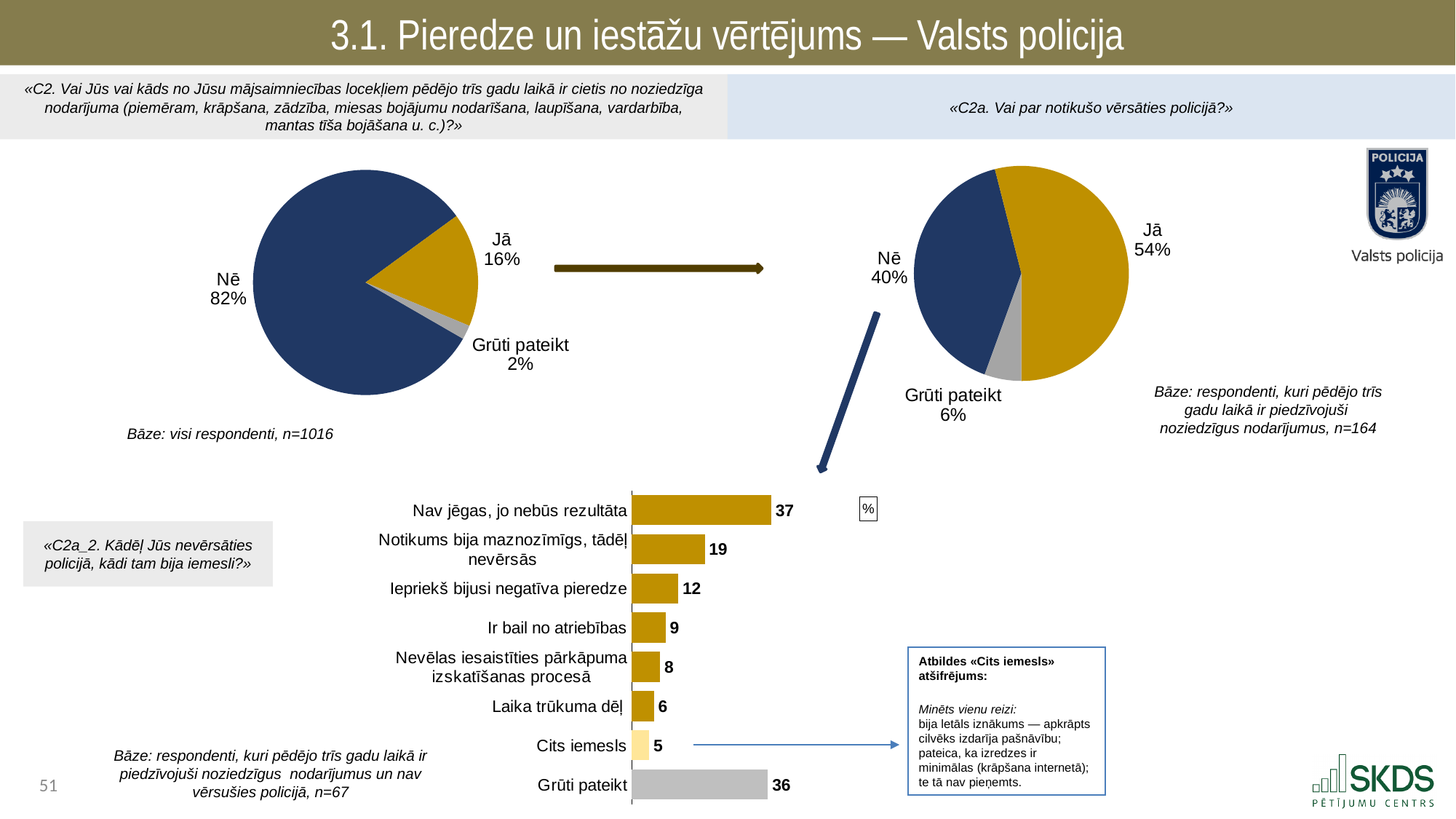
In the bottom bar chart (C2a_2), what is the difference between "Nav jēgas, jo nebūs rezultāta" and "Grūti pateikt"? 1 In the bottom bar chart (C2a_2), which is larger: "Notikums bija maznozīmīgs, tādēļ nevērsās" or "Iepriekš bijusi negatīva pieredze"? Notikums bija maznozīmīgs, tādēļ nevērsās What type of chart is used for question C2a_2 at the bottom of the slide? Bar chart In the right pie chart (C2a), which answer has the smallest share? Grūti pateikt In the bottom bar chart (C2a_2), which category has the lowest value? Cits iemesls In the left pie chart (C2), what share of respondents answered "Nē"? 82% In the bottom bar chart (C2a_2), what is the value for "Ir bail no atriebības"? 9 In the right pie chart (C2a), what is the difference between the "Jā" and "Nē" shares? 14% In the left pie chart (C2), what share of respondents answered "Jā"? 16% In the right pie chart (C2a), what share of respondents answered "Jā"? 54% In the bottom bar chart (C2a_2), what is the value for "Nav jēgas, jo nebūs rezultāta"? 37 How many categories are shown in the bottom bar chart (C2a_2)? 8